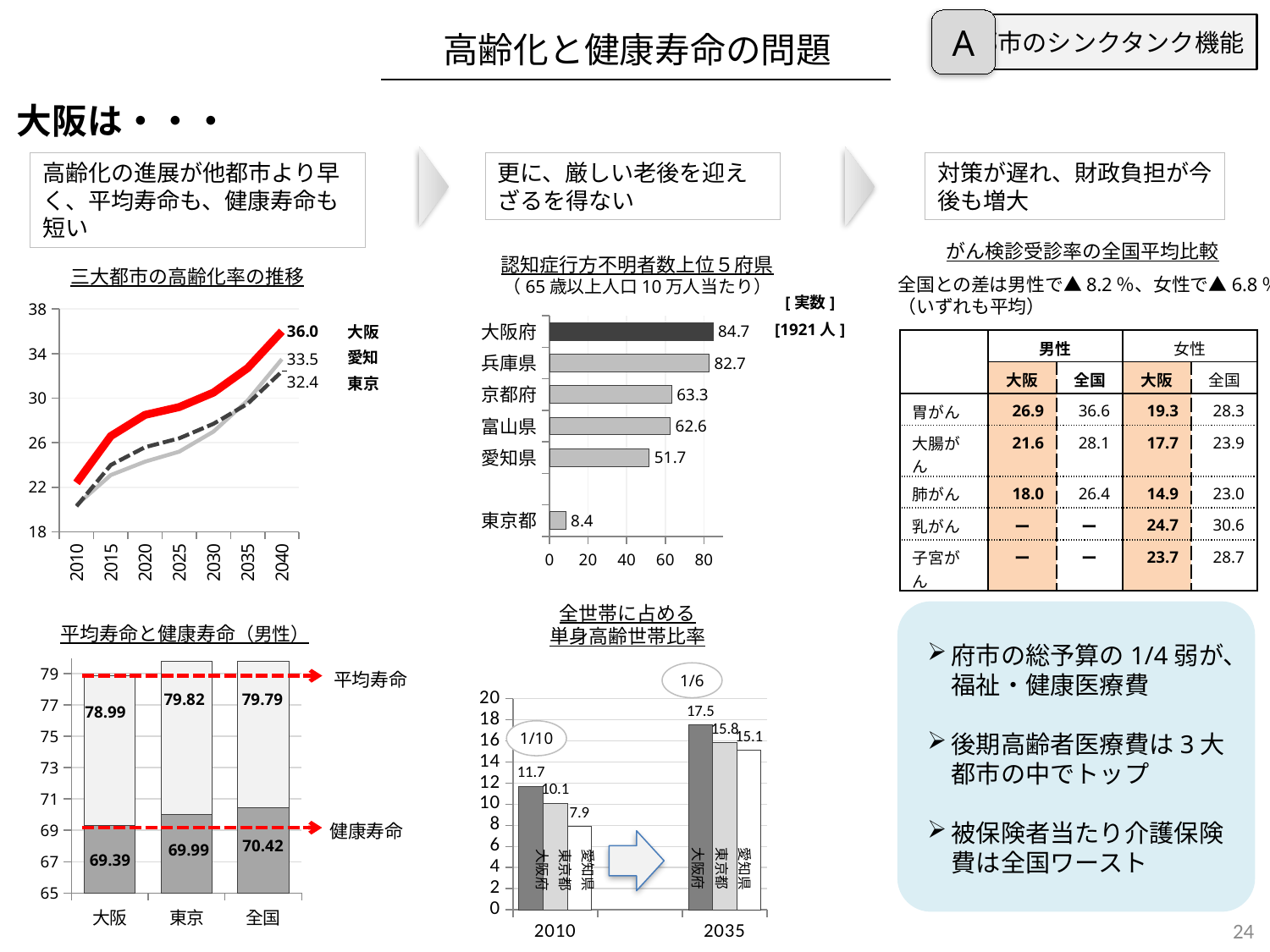
In the chart titled 認知症行方不明者数上位５府県, which prefecture has the lowest value? 東京都 In the chart titled 三大都市の高齢化率の推移, what is the value for 大阪 in 2040? 36.0 In the chart titled 認知症行方不明者数上位５府県, which prefecture has the highest value? 大阪府 In the chart titled 認知症行方不明者数上位５府県, what is the value for 京都府? 63.3 In the chart titled 平均寿命と健康寿命（男性）, which has the larger 平均寿命 value, 東京 or 大阪? 東京 In the chart titled 平均寿命と健康寿命（男性）, what is the 健康寿命 value for 大阪? 69.39 What kind of chart is 認知症行方不明者数上位５府県? bar chart In the chart titled 認知症行方不明者数上位５府県, how many prefectures are shown as bars? 6 In the chart titled 三大都市の高齢化率の推移, how many series (cities) are plotted? 3 In the chart titled 認知症行方不明者数上位５府県, what is the difference between the values for 大阪府 and 兵庫県? 2.0 In the chart titled 三大都市の高齢化率の推移, do the values rise or fall from 2010 to 2040? rise In the chart titled 全世帯に占める単身高齢世帯比率, what is the value for 大阪府 in 2035? 17.5